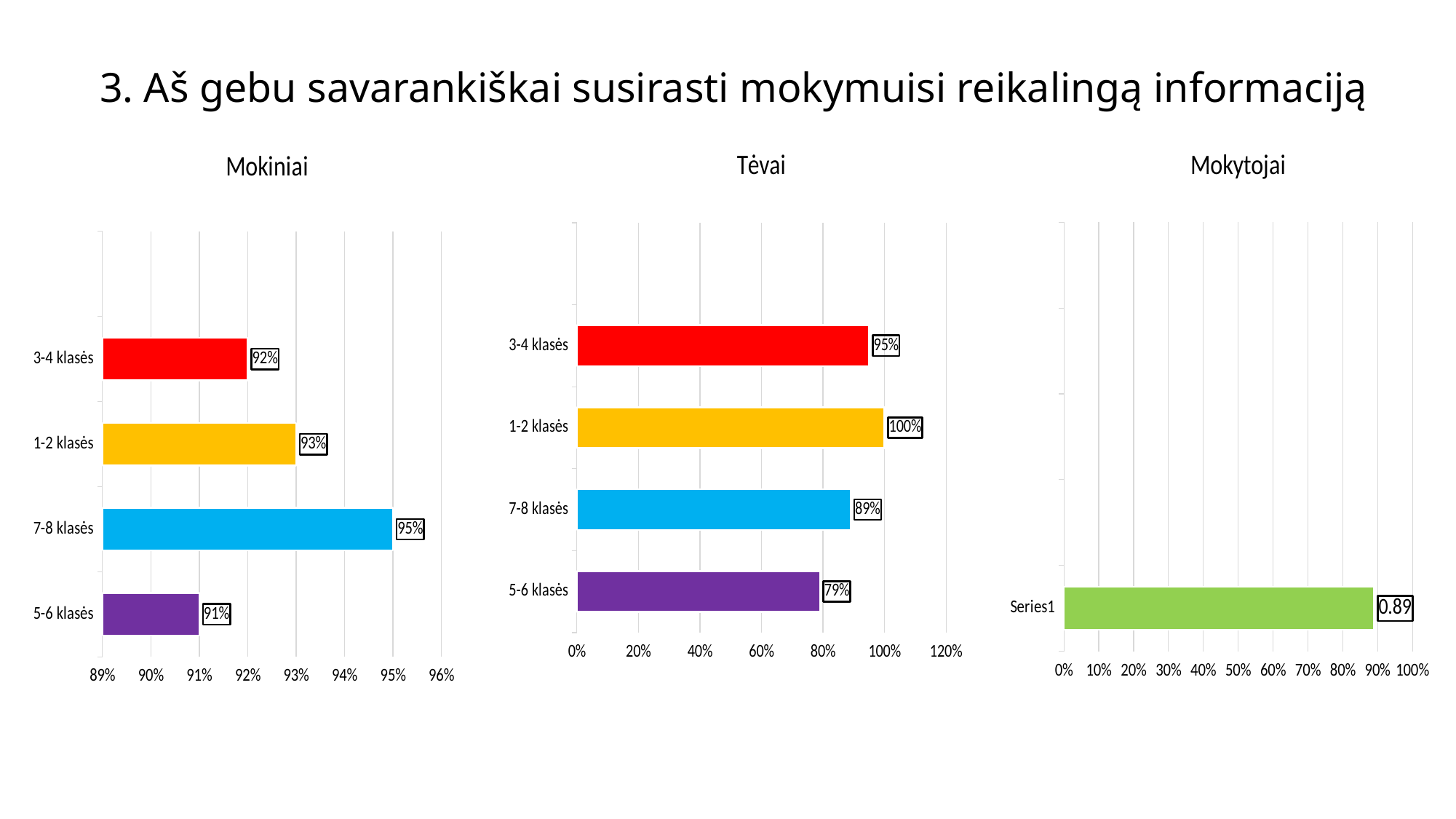
How many categories does the Tėvai chart show? 4 In the Mokiniai chart, what is the difference between the values for 7-8 klasės and 5-6 klasės? 4% In the Mokiniai chart, which category has the lowest value? 5-6 klasės In the Tėvai chart, what is the difference between the values for 1-2 klasės and 5-6 klasės? 21% What is the title of the chart on the left of the slide? Mokiniai In the Tėvai chart, what is the value for 5-6 klasės? 79% In the Tėvai chart, which is larger, the value for 3-4 klasės or the value for 7-8 klasės? 3-4 klasės In the Mokiniai chart, what is the value for 7-8 klasės? 95% What kind of chart is the Mokytojai chart? Bar chart In the Mokiniai chart, what is the value for 3-4 klasės? 92% In the Mokytojai chart, what is the value shown for Series1? 0.89 In the Tėvai chart, which category has the highest value? 1-2 klasės